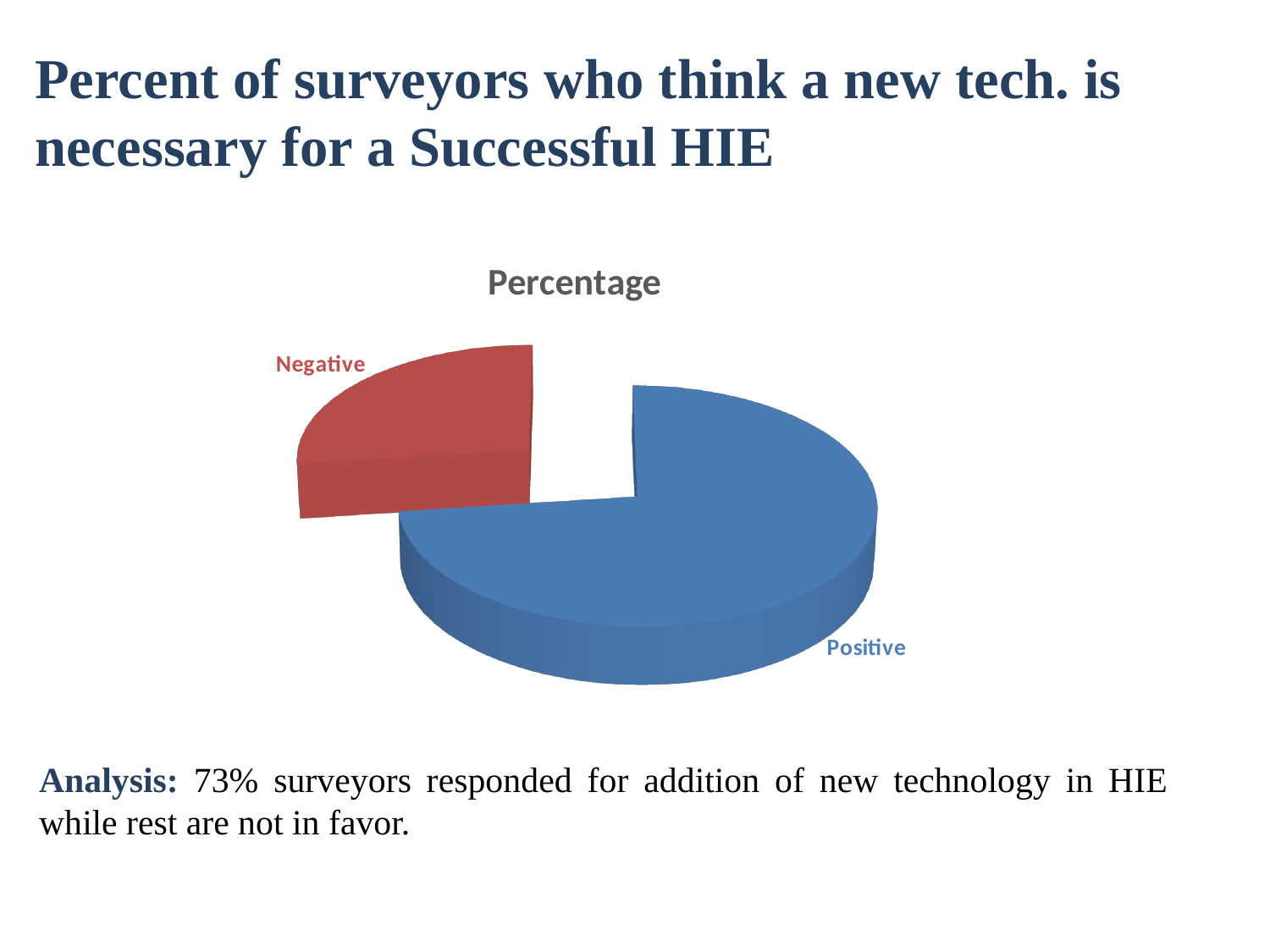
What is the title of the pie chart? Percentage What kind of chart is shown on the slide? pie chart Which slice of the pie chart is the smallest? Negative Which slice is larger, Positive or Negative? Positive Which slice of the pie chart is the largest? Positive How many slices does the pie chart have? 2 What colour is the Negative slice of the pie chart? red